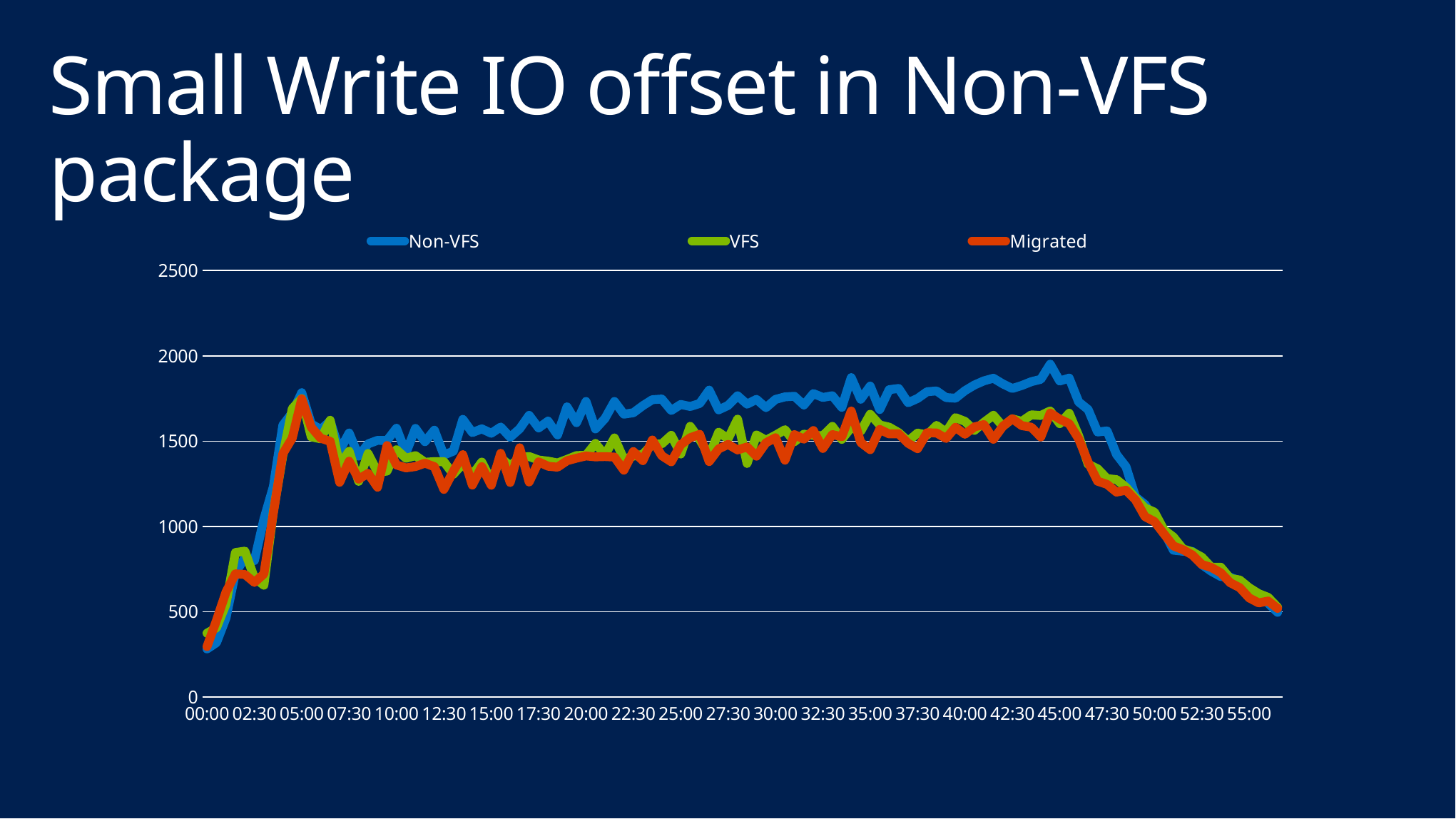
Is the value for Migrated at 55:00 greater or less than 1000? less Is the value for Migrated at 15:00 greater or less than 1500? less Is the value for Non-VFS at 45:00 greater or less than 1500? greater Between 45:00 and 55:00, do the values of the Non-VFS series rise or fall? fall What is the highest value labelled on the vertical axis? 2500 Which series reaches the highest value anywhere on the chart? Non-VFS How many series does the legend list? 3 At 35:00, which series has the higher value, Non-VFS or VFS? Non-VFS What are the three series named in the legend? Non-VFS, VFS, Migrated At 30:00, which series has the higher value, Non-VFS or Migrated? Non-VFS What kind of chart is shown on the slide? line chart